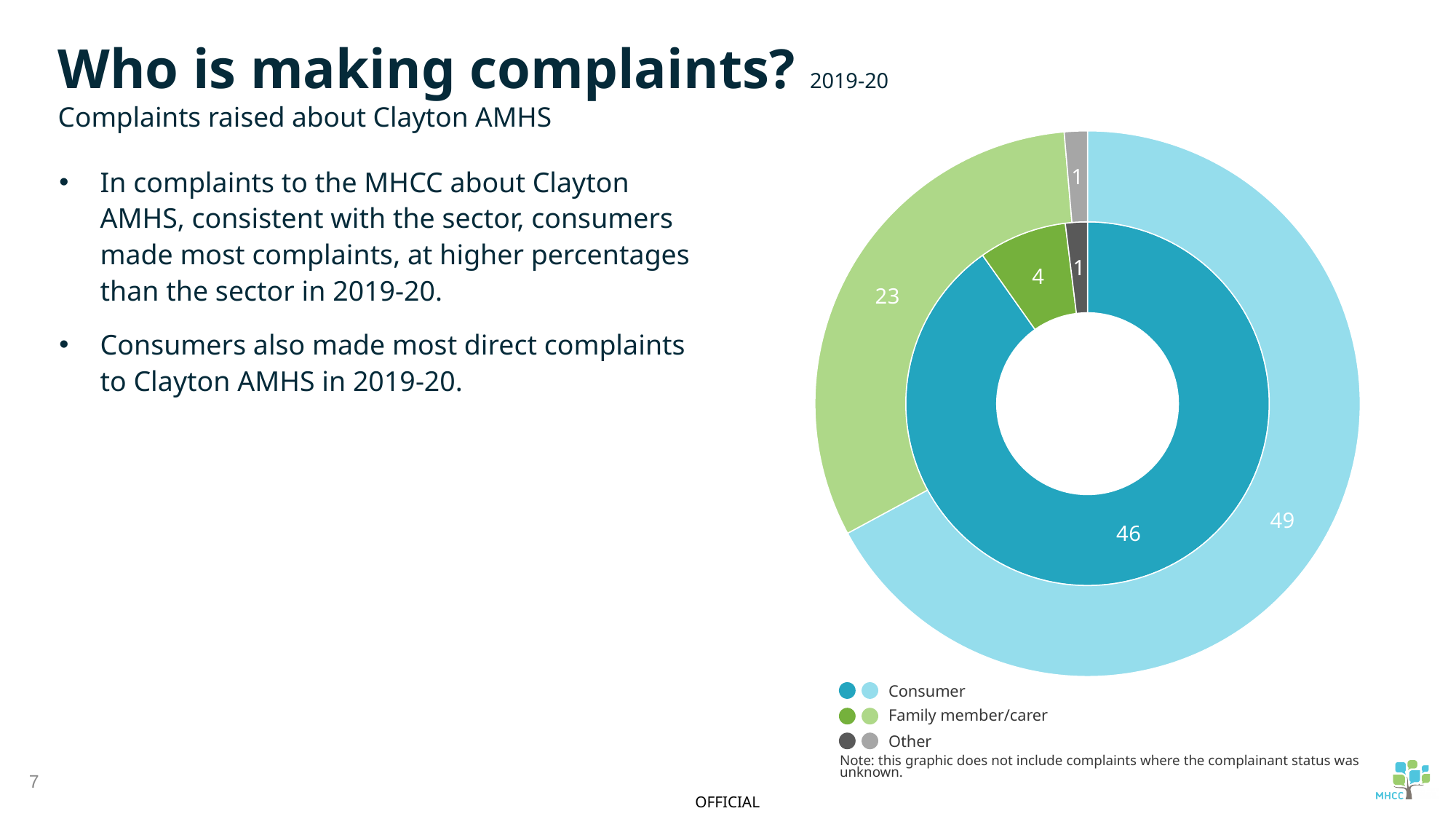
Which category has the smallest value in the inner ring of the doughnut chart? Other Which category is shown in green in the doughnut chart? Family member/carer In the outer ring of the doughnut chart, what is the difference between the Consumer value and the Family member/carer value? 26 What is the value for Other in the inner ring of the doughnut chart? 1 What is the value for Consumer in the outer ring of the doughnut chart? 49 What is the value for Family member/carer in the outer ring of the doughnut chart? 23 In the inner ring of the doughnut chart, which is larger: the Consumer value or the Family member/carer value? Consumer What is the value for Family member/carer in the inner ring of the doughnut chart? 4 How many categories does the legend of the doughnut chart list? 3 What kind of chart is shown on the slide? Doughnut chart Which category has the largest value in the outer ring of the doughnut chart? Consumer What is the value for Consumer in the inner ring of the doughnut chart? 46